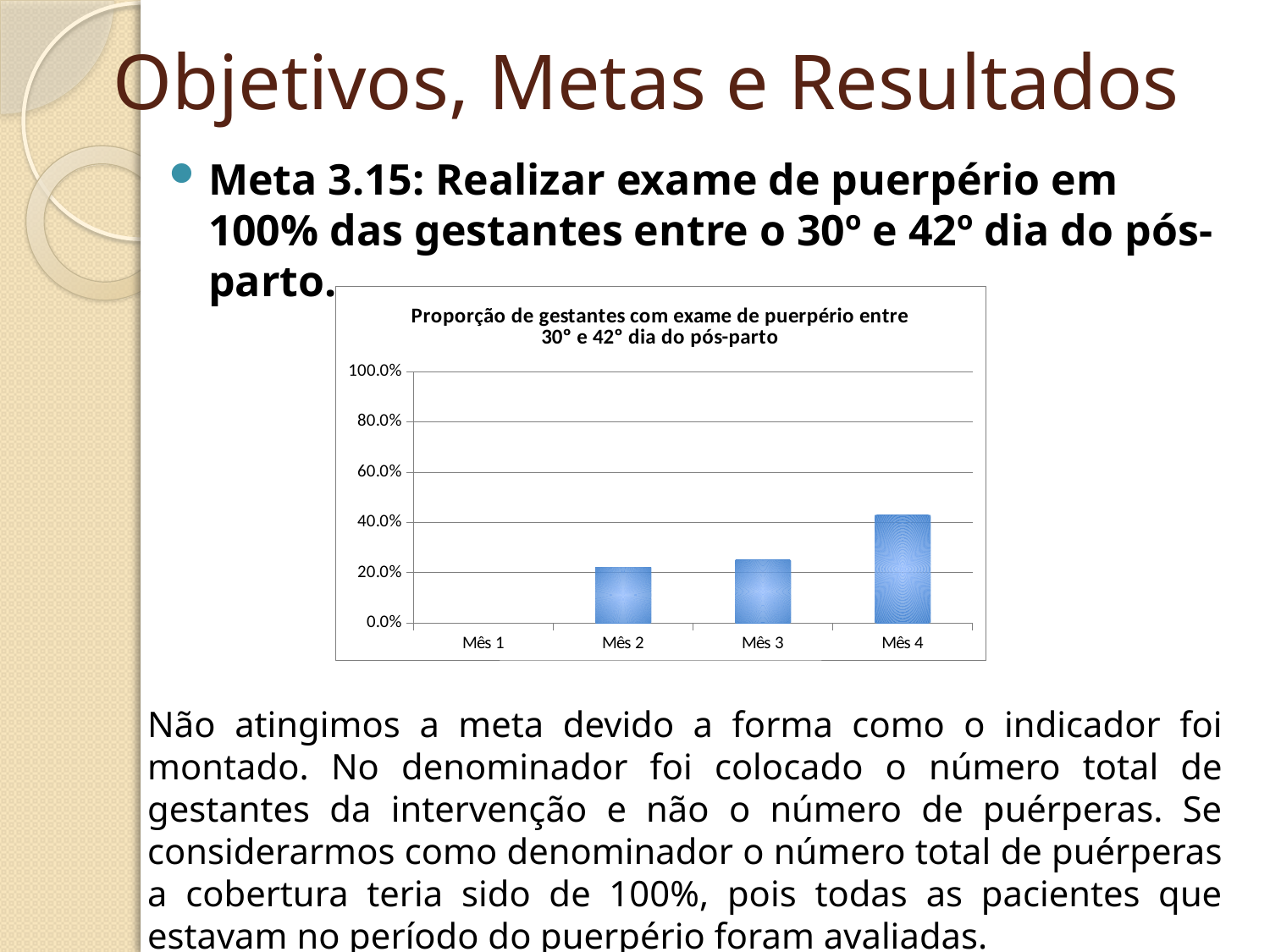
Is the value for Mês 3 greater or less than 40.0%? less How many categories (months) are shown on the x axis of the chart? 4 Which month has the lowest proportion in the chart? Mês 1 Is the value for Mês 4 greater or less than 20.0%? greater Is the value for Mês 4 greater or less than 60.0%? less Which month has the highest proportion in the chart? Mês 4 What kind of chart is shown on the slide? bar chart What is the value for Mês 1 in the chart? 0.0% Do the values rise or fall from Mês 1 to Mês 4? rise Which is larger, the value for Mês 4 or the value for Mês 2? Mês 4 What is the title of the chart? Proporção de gestantes com exame de puerpério entre 30° e 42° dia do pós-parto